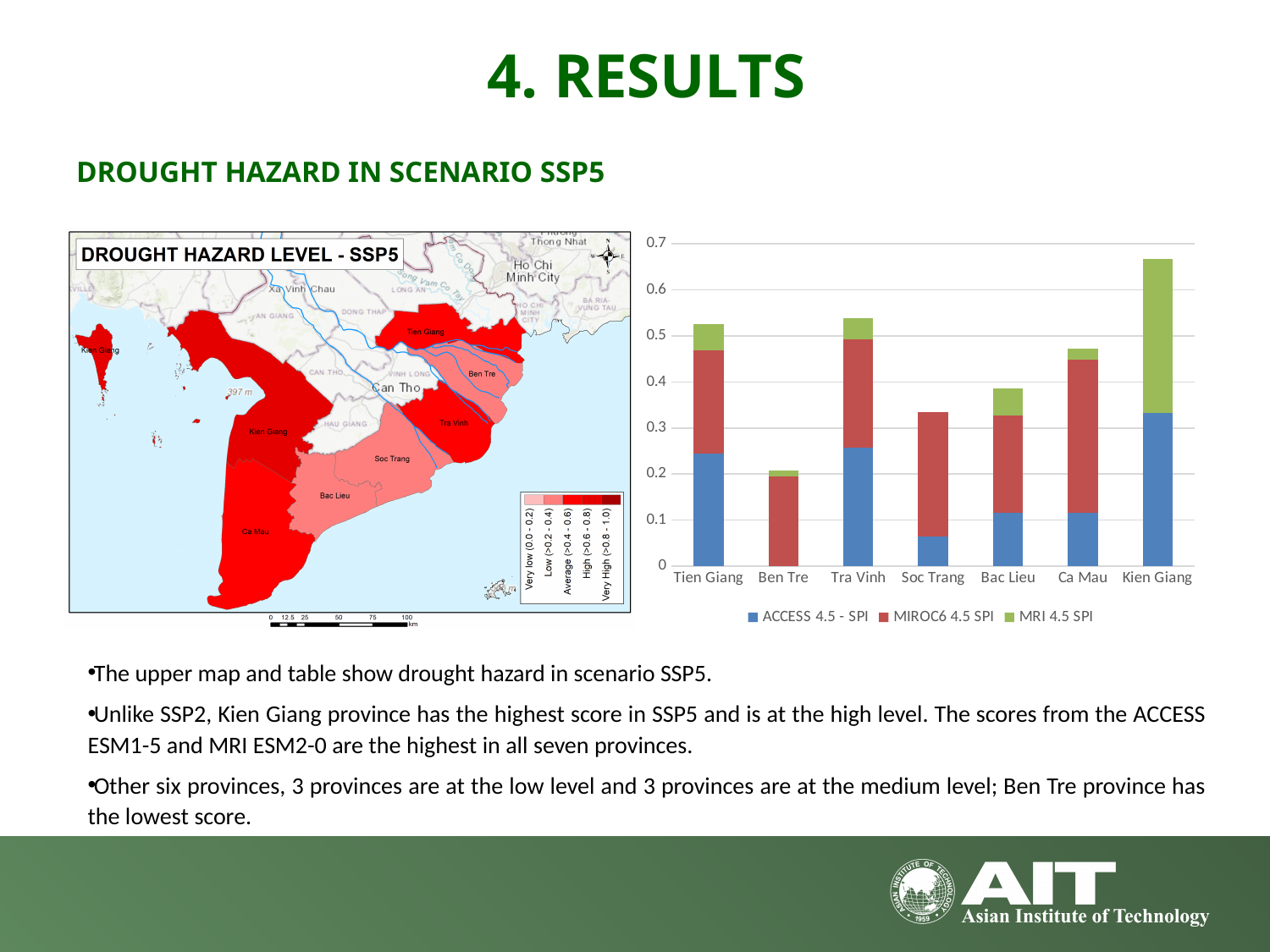
Is the total stacked value for Ben Tre greater or less than 0.3? less Which province has the larger total stacked value, Tra Vinh or Soc Trang? Tra Vinh Is the ACCESS 4.5 - SPI value for Soc Trang greater or less than 0.1? less Which province has the larger total stacked value, Ca Mau or Bac Lieu? Ca Mau Which series in the bar chart is shown in green? MRI 4.5 SPI Is the total stacked value for Soc Trang greater or less than 0.4? less How many series does the legend of the bar chart list? 3 How many provinces are shown on the x axis of the bar chart? 7 Which province has the tallest stacked bar in the chart? Kien Giang Which province has the shortest stacked bar in the chart? Ben Tre What kind of chart is shown on the right of the slide? Stacked bar chart